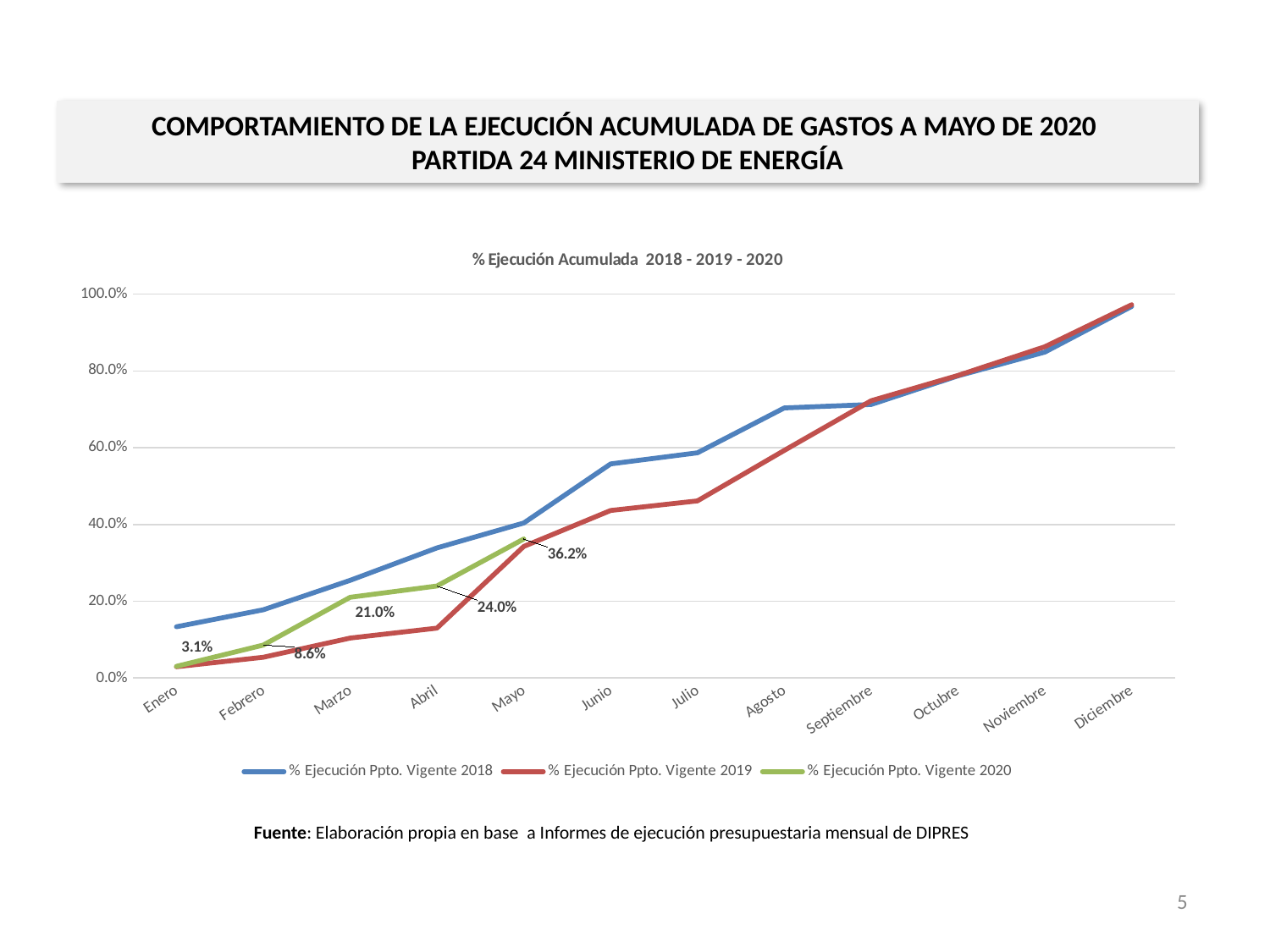
How many months are shown on the x axis? 12 What is the value for % Ejecución Ppto. Vigente 2020 in Mayo? 36.2% Among the labeled 2020 values, which month has the highest value? Mayo What is the difference between the 2020 values for Mayo and Abril? 12.2 percentage points What is the title of the chart? % Ejecución Acumulada 2018 - 2019 - 2020 What is the value for % Ejecución Ppto. Vigente 2020 in Abril? 24.0% Is the value for % Ejecución Ppto. Vigente 2018 in Agosto greater or less than 60.0%? greater What type of chart is shown on the slide? Line chart In Junio, which series has the larger value: % Ejecución Ppto. Vigente 2018 or % Ejecución Ppto. Vigente 2019? % Ejecución Ppto. Vigente 2018 How many series does the legend list? 3 What is the value for % Ejecución Ppto. Vigente 2020 in Marzo? 21.0% What is the value for % Ejecución Ppto. Vigente 2020 in Enero? 3.1%